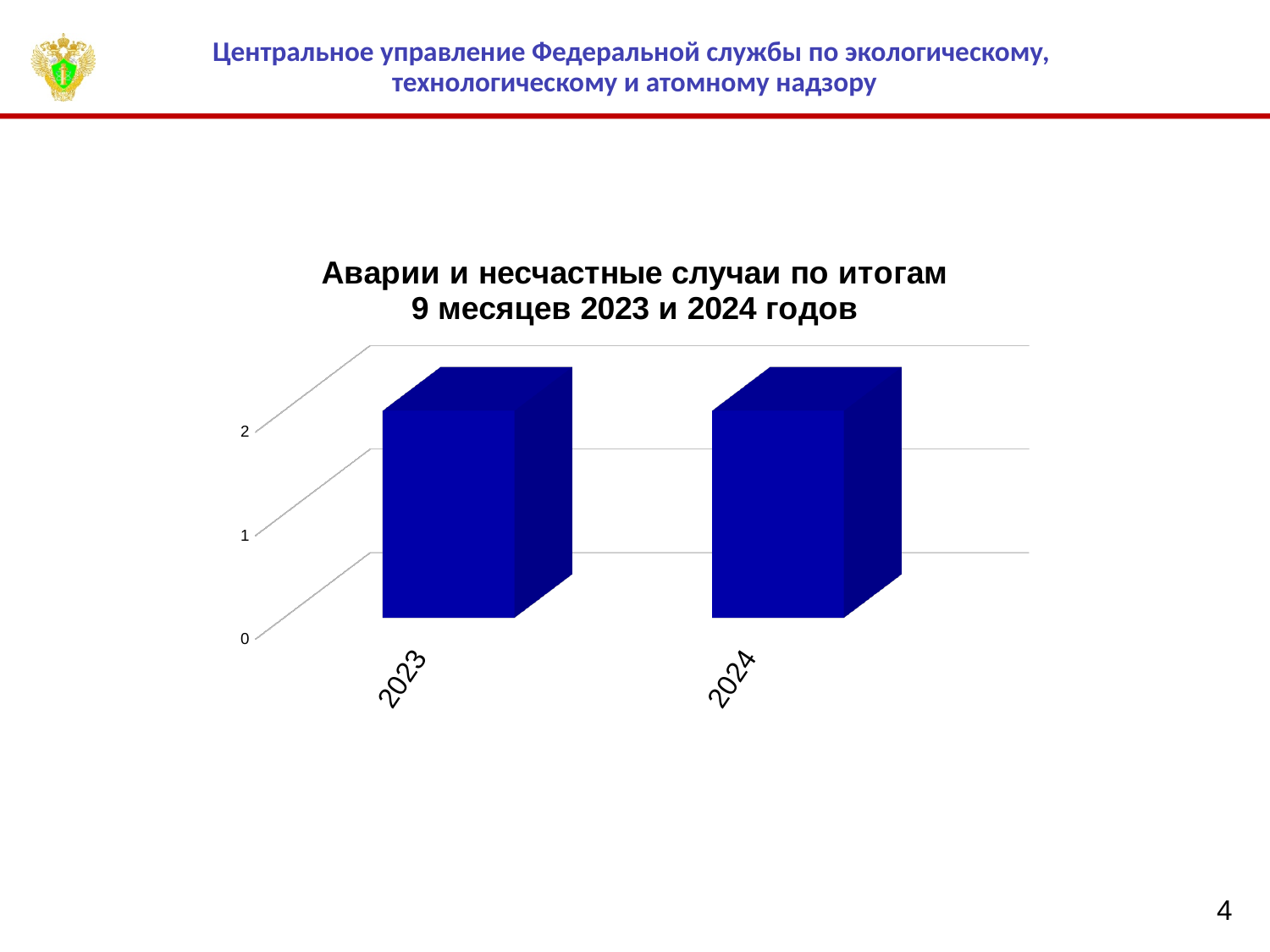
What kind of chart is shown on the slide? bar chart Is the value for 2023 greater or less than 1? greater What is the highest tick value shown on the vertical axis? 2 Is the value for 2024 greater or less than 1? greater Which years are shown as categories on the x axis? 2023 and 2024 What is the title of the chart? Аварии и несчастные случаи по итогам 9 месяцев 2023 и 2024 годов How many categories (years) are shown on the x axis of the chart? 2